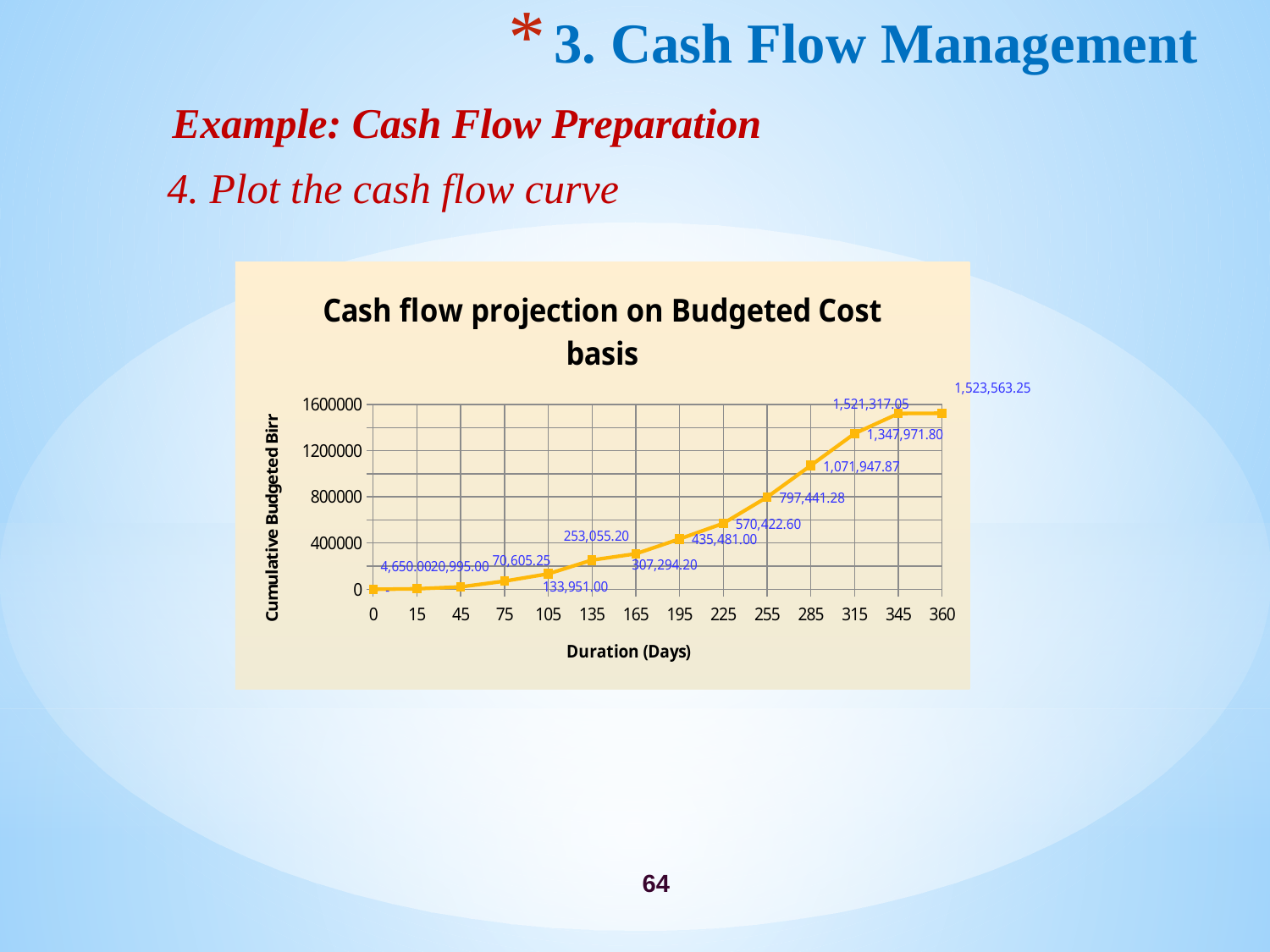
What type of chart is shown on the slide? Line chart What is the title of the chart? Cash flow projection on Budgeted Cost basis Is the cumulative budgeted Birr at 285 days greater or less than 800000? greater What is the difference between the cumulative budgeted Birr at 315 days and at 285 days? 276,023.93 How many data points are plotted on the line? 14 What is the cumulative budgeted Birr at 255 days? 797,441.28 At which duration is the cumulative budgeted Birr highest? 360 What is the cumulative budgeted Birr at 75 days? 70,605.25 What is the cumulative budgeted Birr at 360 days? 1,523,563.25 What is the label of the x axis of the chart? Duration (Days) Which is larger, the cumulative budgeted Birr at 195 days or at 225 days? 225 days What is the cumulative budgeted Birr at 135 days? 253,055.20